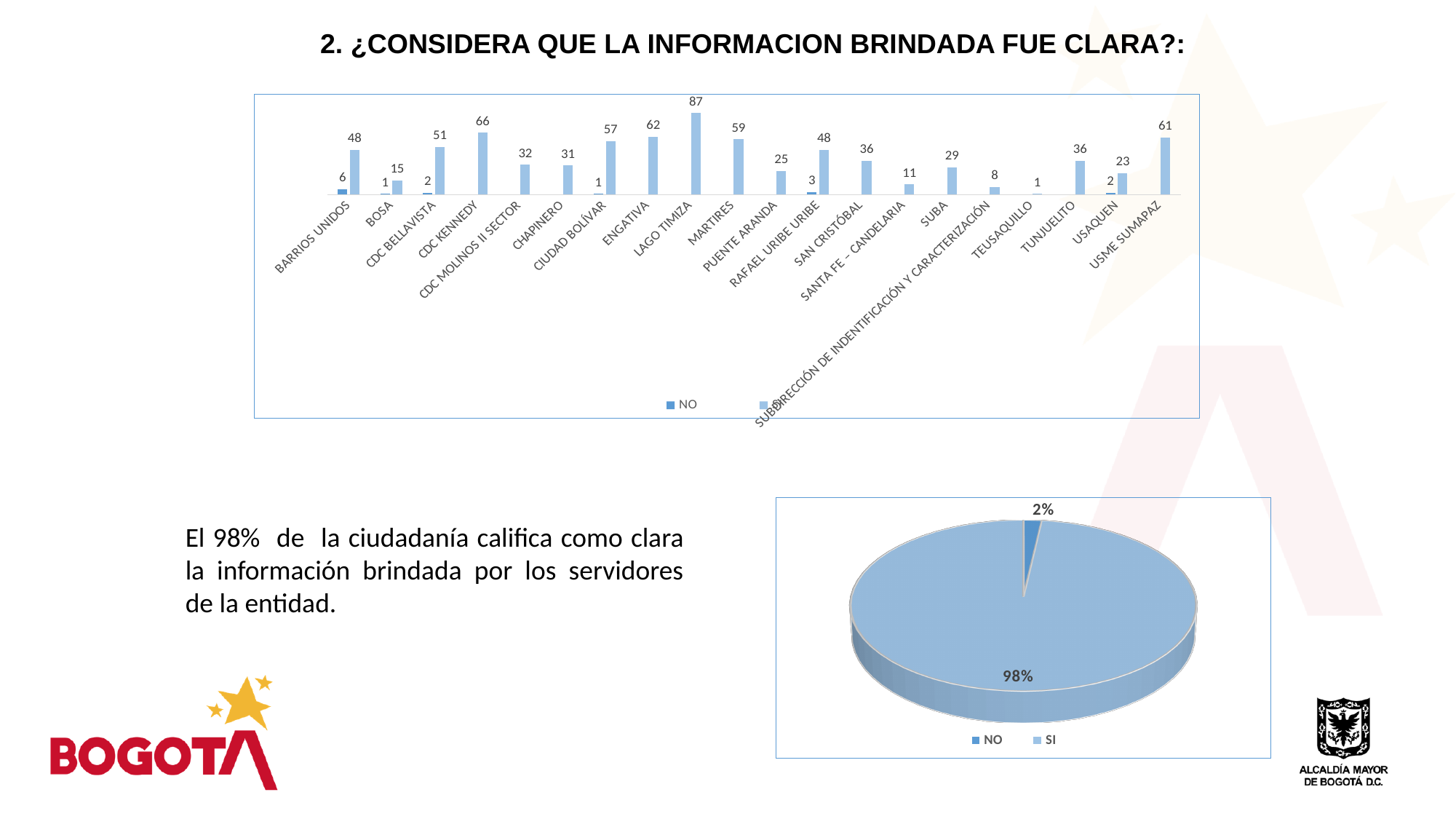
In the bar chart, what is the SI value for LAGO TIMIZA? 87 In the pie chart, what share does SI have? 98% In the bar chart, which has a larger SI value, ENGATIVA or MARTIRES? ENGATIVA What kind of chart is the chart at the bottom right of the slide? pie chart In the bar chart, what is the difference between the SI values for LAGO TIMIZA and CDC KENNEDY? 21 In the bar chart, what is the NO value for BARRIOS UNIDOS? 6 In the bar chart, which category has the lowest SI value? TEUSAQUILLO What kind of chart is the top chart on the slide? bar chart In the bar chart, how many categories are shown on the x axis? 20 In the pie chart, what share does NO have? 2% In the bar chart, which category has the highest SI value? LAGO TIMIZA How many entries does the legend of the pie chart list? 2